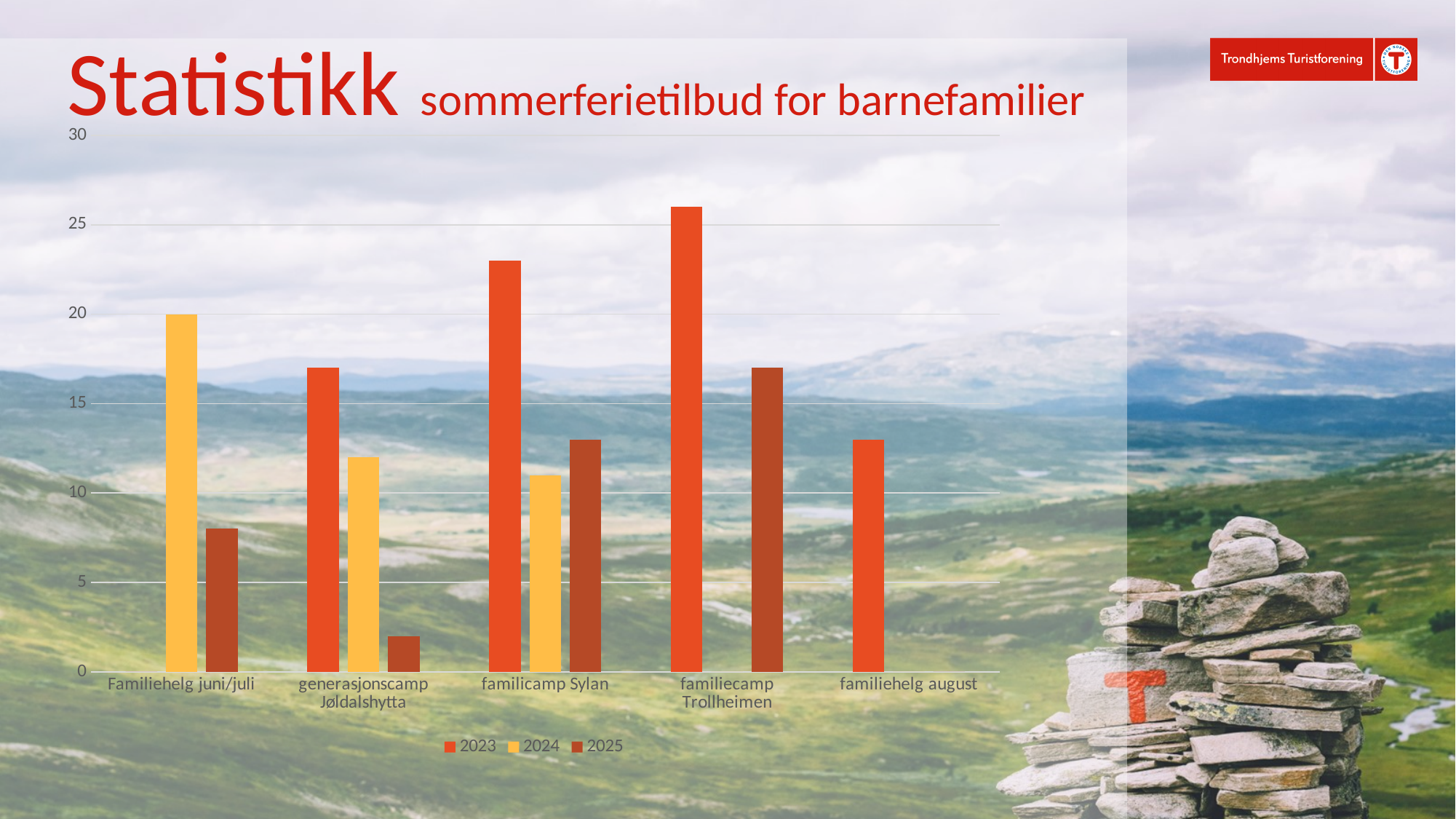
Is the 2025 value for Familiehelg juni/juli greater or less than 10? less How many categories are shown on the x axis of the chart? 5 How many series does the chart's legend list? 3 What kind of chart is shown on the slide? Bar chart Is the 2023 value for familiecamp Trollheimen greater or less than 25? greater What is the 2024 value for Familiehelg juni/juli? 20 Is the 2023 value for familicamp Sylan greater or less than 20? greater Which category has the highest 2023 value? familiecamp Trollheimen Which years are listed in the chart's legend? 2023, 2024, 2025 For familiecamp Trollheimen, which is larger: the 2023 value or the 2025 value? 2023